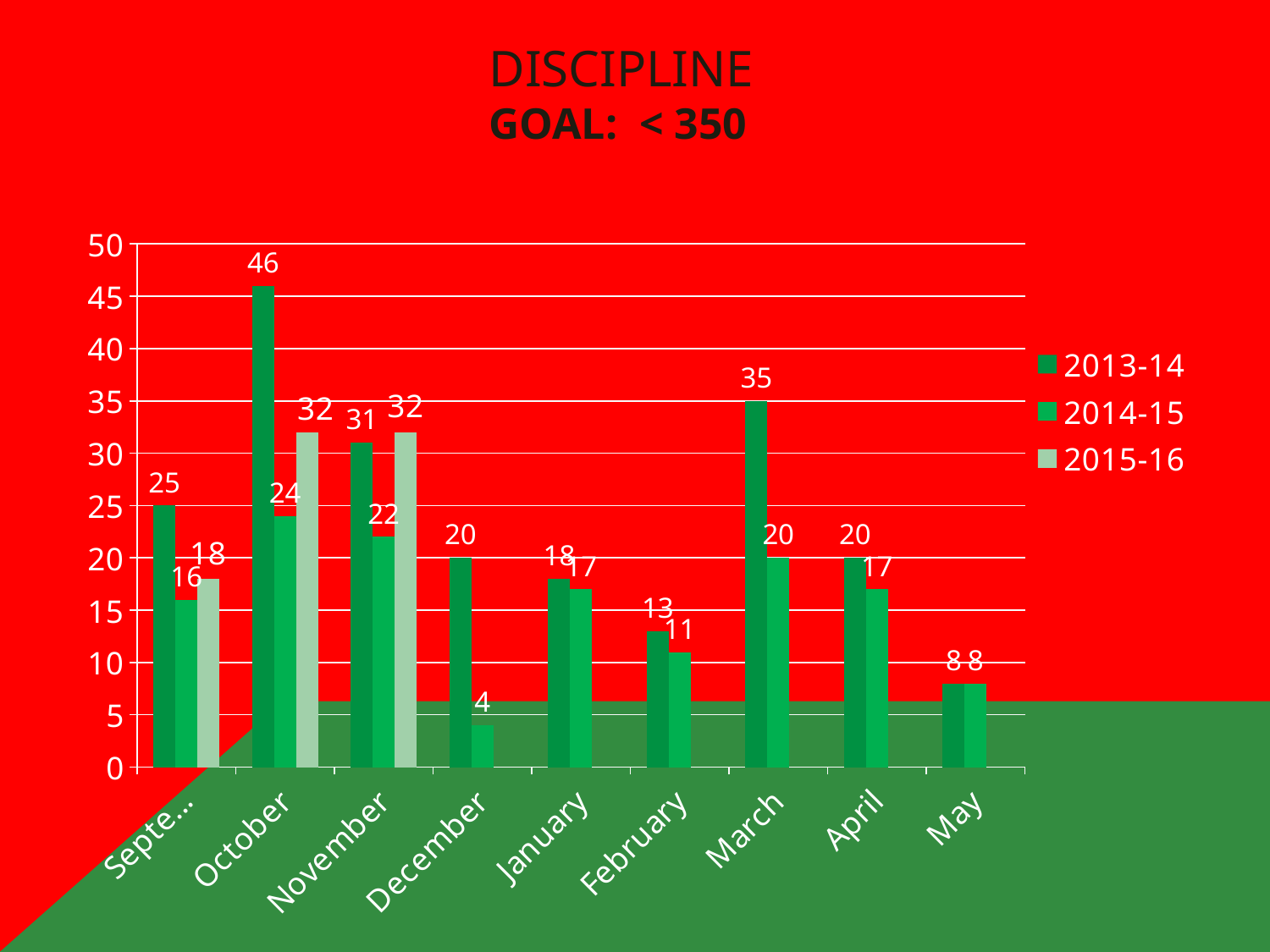
What is the difference between the 2013-14 and 2014-15 values in March? 15 What is the value for 2013-14 in October? 46 In which month is the 2013-14 value highest? October In which month is the 2014-15 value lowest? December What is the value for 2014-15 in December? 4 What is the value for 2014-15 in November? 22 How many series does the legend list? 3 What kind of chart is shown on the slide? bar chart How many months are shown on the x axis? 9 In March, which series has the larger value, 2013-14 or 2014-15? 2013-14 What is the difference between the 2013-14 and 2014-15 values in October? 22 What is the value for 2015-16 in November? 32